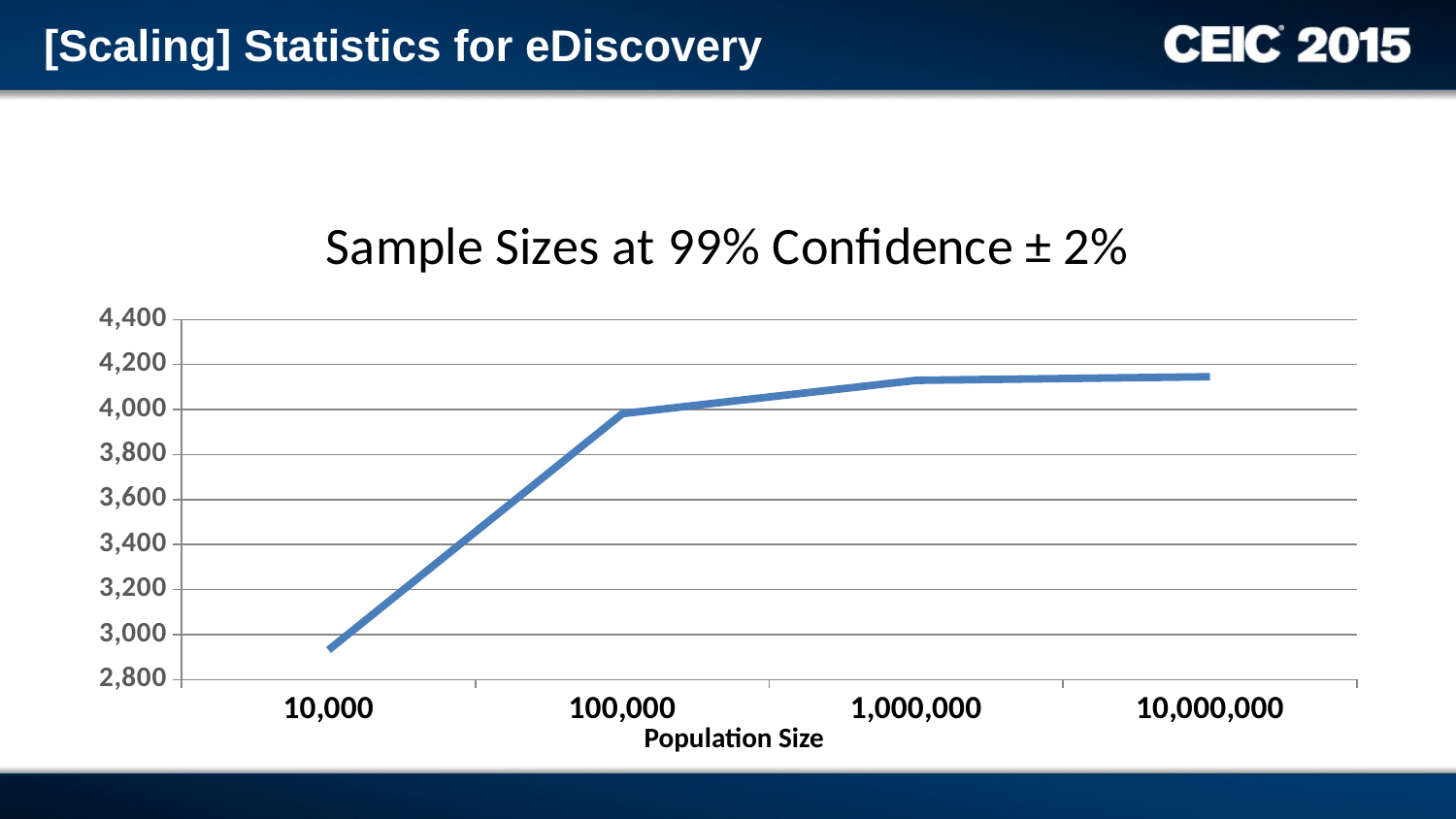
How many population sizes are plotted on the x axis? 4 Is the sample size for a population of 1,000,000 greater or less than 4,000? greater What is the label of the x axis? Population Size Is the sample size for a population of 10,000 greater or less than 3,200? less What kind of chart is shown on the slide? Line chart Which has the larger sample size, a population of 100,000 or a population of 1,000,000? 1,000,000 What is the title of the chart? Sample Sizes at 99% Confidence ± 2% Does the sample size rise or fall as population size increases along the x axis? Rises Which population size has the lowest sample size? 10,000 Is the sample size for a population of 100,000 greater or less than 3,800? greater Which has the larger sample size, a population of 10,000 or a population of 100,000? 100,000